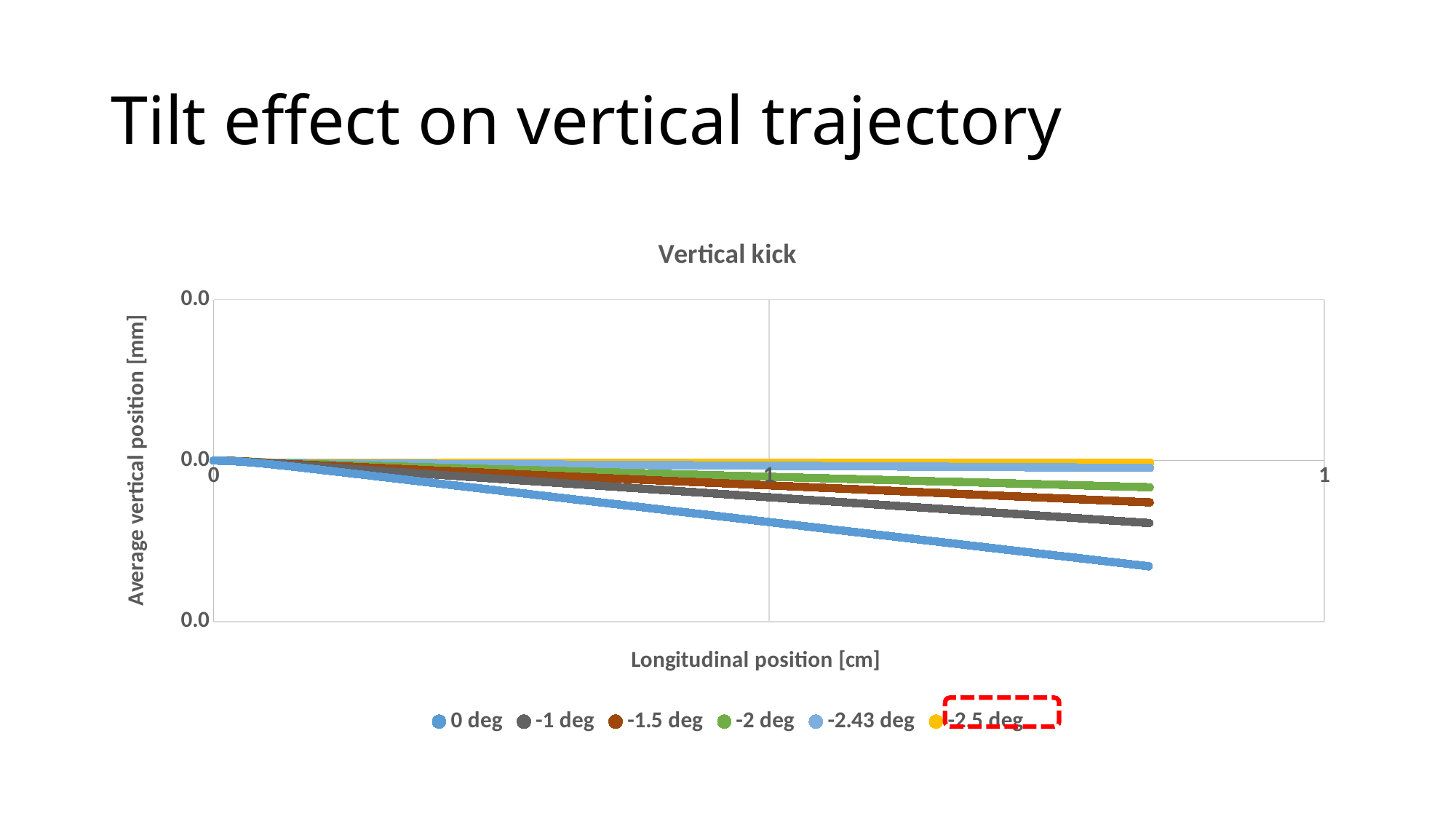
Which legend entry is highlighted with a red dashed box? -2.5 deg At the right end of the lines, which series has the lower vertical position: -1.5 deg or -2.43 deg? -1.5 deg At the right end of the lines, which series has the lower vertical position: -1 deg or -2 deg? -1 deg Do the values of the 0 deg series rise or fall as longitudinal position increases? fall How many series does the legend list? 6 What is the label of the vertical axis? Average vertical position [mm] At the right end of the lines, which series has the lower vertical position: 0 deg or -1 deg? 0 deg Do the values of the -1 deg series rise or fall along the x axis? fall Which series drops the furthest below zero by the right end of the lines? 0 deg What is the title of the chart? Vertical kick What kind of chart is shown on the slide? line chart